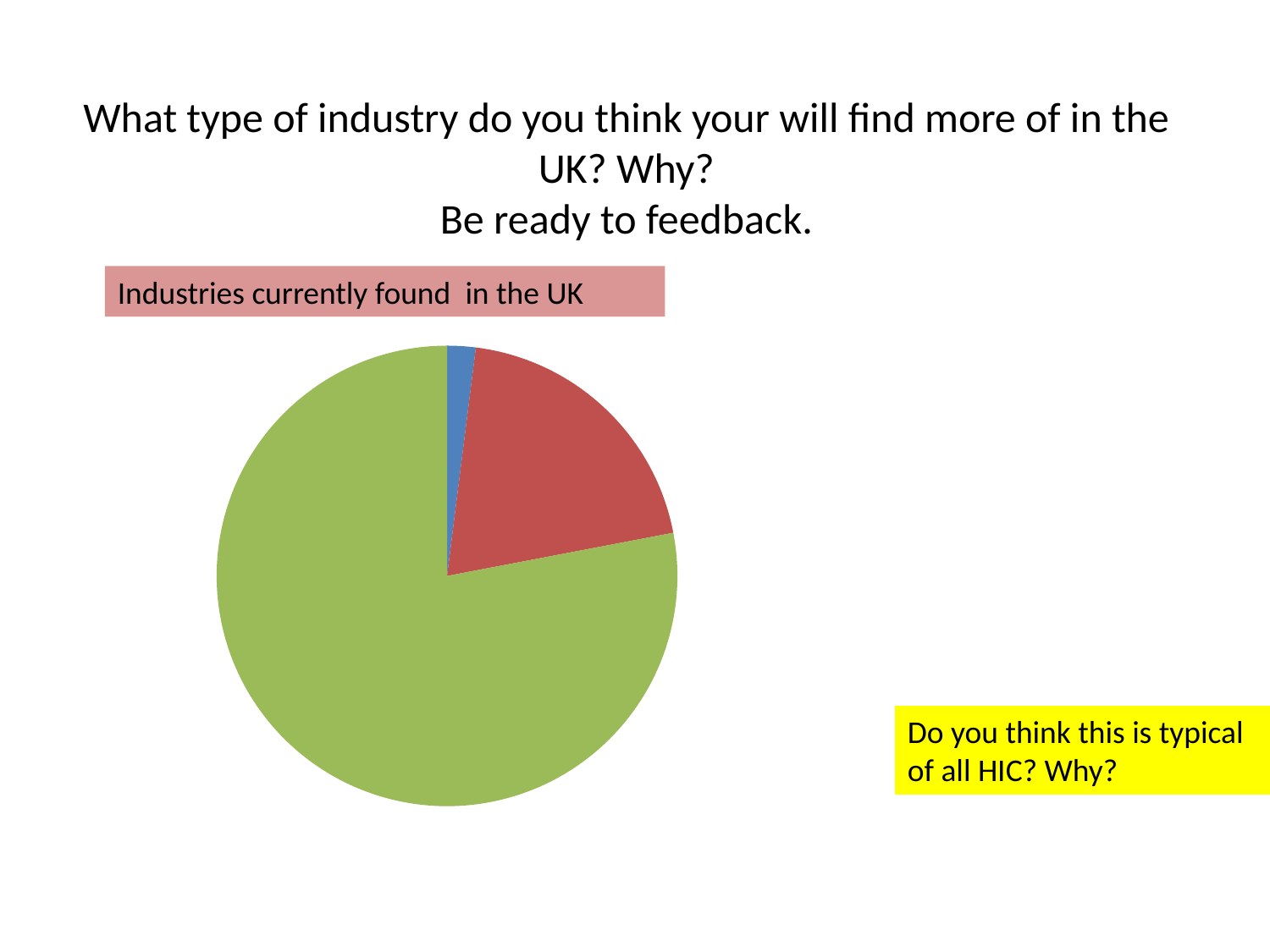
Is the green slice greater or less than half of the pie? greater Which slice is larger, the red slice or the blue slice? red What is the title shown above the pie chart? Industries currently found in the UK Which slice is larger, the green slice or the red slice? green Does the pie chart display a legend? No Which colour slice is the smallest in the pie chart? blue How many slices does the pie chart have? 3 What kind of chart is shown on the slide? pie chart Which colour slice is the largest in the pie chart? green